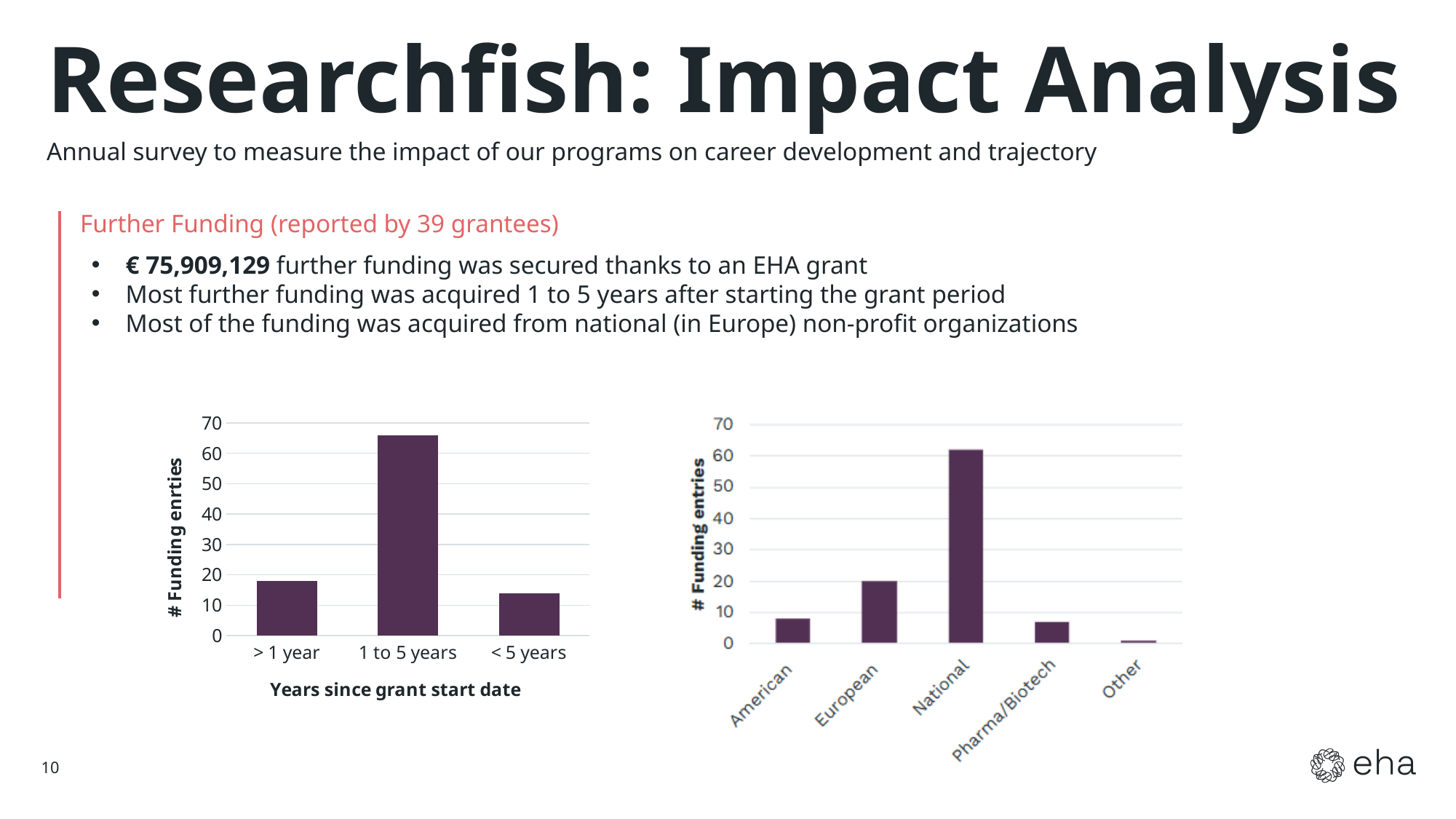
On the right chart (funding source), how many categories are shown on the x axis? 5 On the left chart (Years since grant start date), which category has the highest number of funding entries? 1 to 5 years On the right chart (funding source), is the value for American greater or less than 10? less On the right chart (funding source), is the value for National greater or less than 60? greater On the right chart (funding source), which category has the lowest number of funding entries? Other On the right chart (funding source), which category has the highest number of funding entries? National On the left chart (Years since grant start date), how many categories are shown on the x axis? 3 On the left chart (Years since grant start date), is the value for 1 to 5 years greater or less than 60? greater On the left chart (Years since grant start date), what is the label of the y axis? # Funding enrties On the left chart (Years since grant start date), which category has the lowest number of funding entries? < 5 years On the right chart (funding source), which has more funding entries, European or American? European